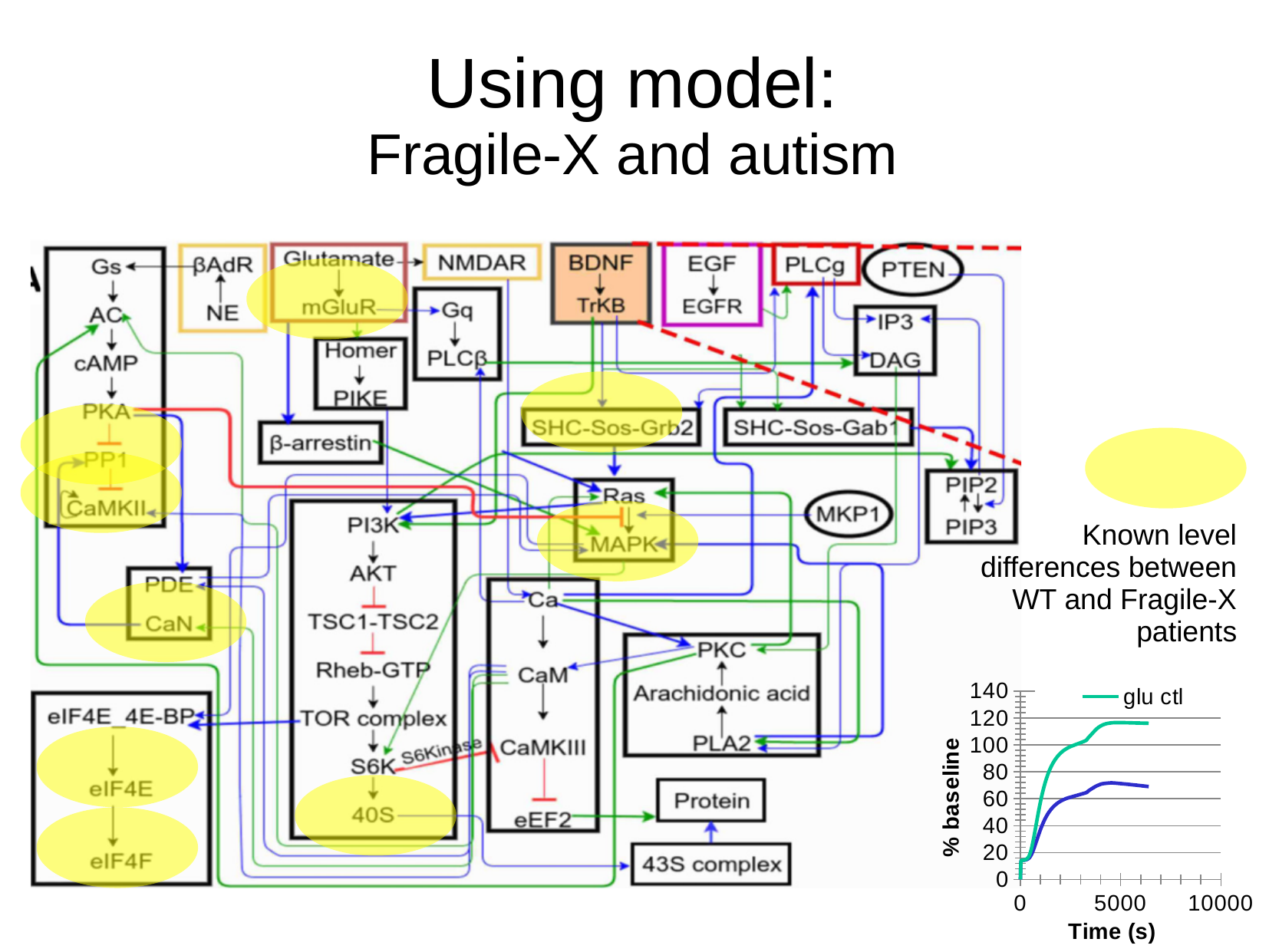
In the bottom-right chart, is the final plateau value of the glu ctl line greater or less than 100? greater In the bottom-right chart, do the values of the glu ctl line rise or fall as time increases? rise In the bottom-right chart, what is the label of the y axis? % baseline In the bottom-right chart, how many entries does the legend list? 1 In the bottom-right chart, is the final plateau value of the blue line greater or less than 60? greater In the bottom-right chart, which line reaches the higher % baseline value, the glu ctl line or the blue line? glu ctl What kind of chart is shown at the bottom right of the slide? line chart In the bottom-right chart, is the final plateau value of the blue line greater or less than 80? less In the bottom-right chart, what is the label of the x axis? Time (s) In the bottom-right chart, what is the highest value shown on the y axis? 140 In the bottom-right chart, how many lines are plotted? 2